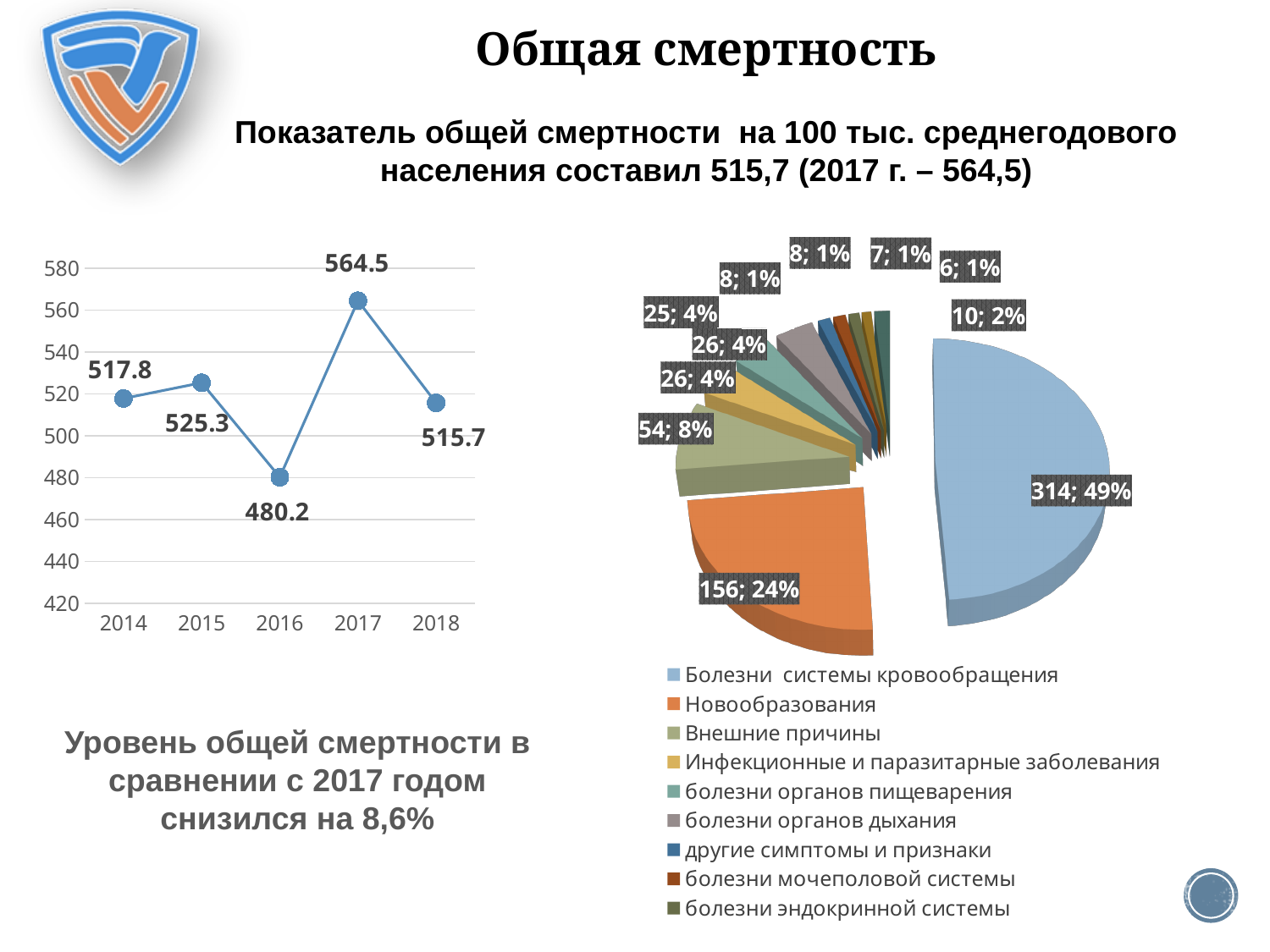
What type of chart is shown on the left of the slide? line chart On the left line chart, which year has the highest value? 2017 On the right pie chart, what share does Болезни системы кровообращения have? 49% On the left line chart, what is the difference between the 2017 and 2018 values? 48.8 On the right pie chart, what is the value shown for Новообразования? 156 How many years are plotted on the left line chart? 5 On the left line chart, does the value rise or fall from 2017 to 2018? fall On the left line chart, which is larger, the value for 2014 or the value for 2015? 2015 How many entries does the legend of the right pie chart list? 9 On the left line chart, which year has the lowest value? 2016 On the left line chart, what was the value for 2016? 480.2 On the left line chart, what was the value for 2017? 564.5